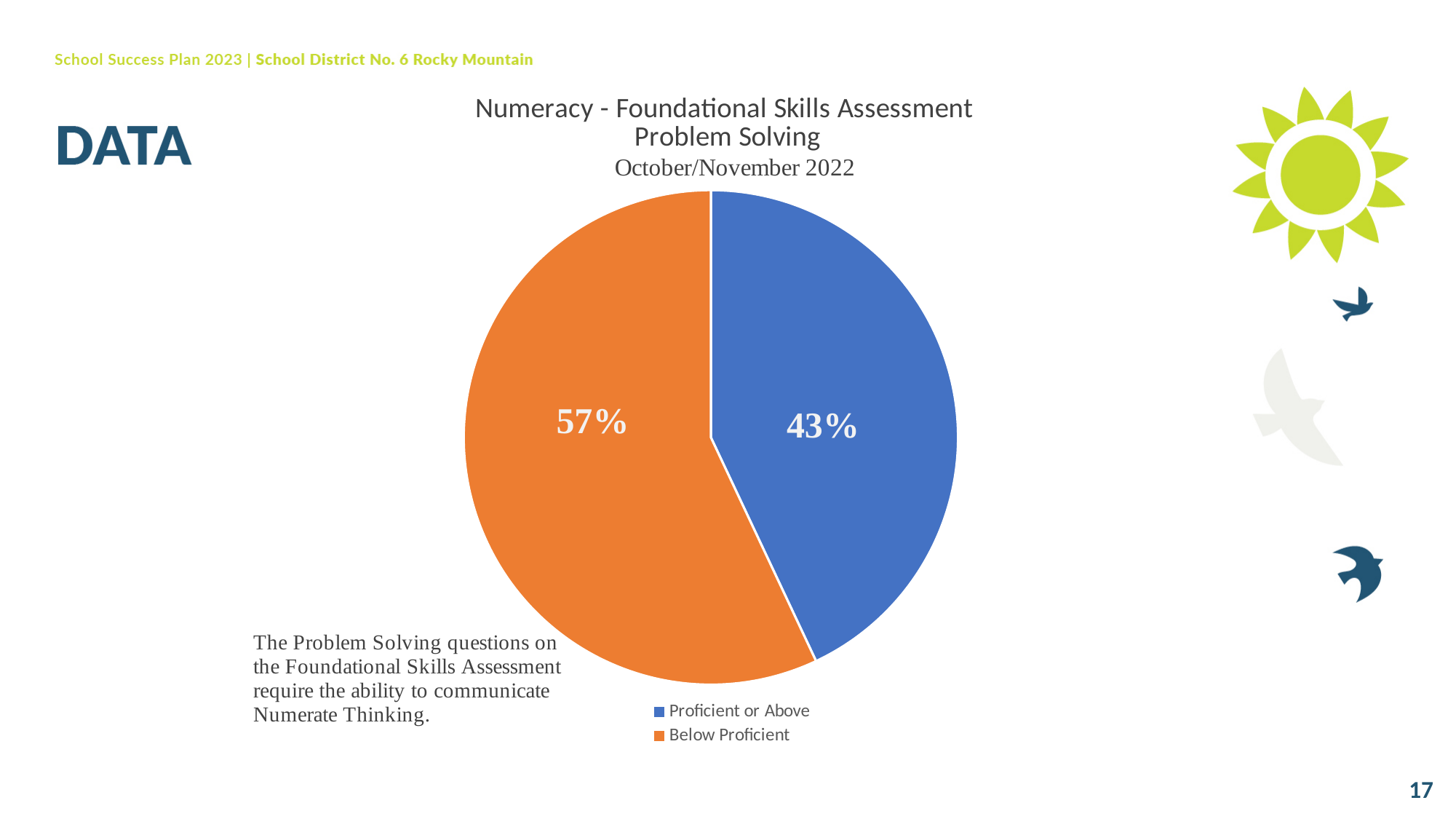
How many entries does the legend list? 2 Which colour represents Proficient or Above in the pie chart? blue What is the share of the pie for Below Proficient? 57% What percentage of the pie is labelled Proficient or Above? 43% Which category has the smaller share of the pie? Proficient or Above How many categories does the pie chart show? 2 What percentage of the pie is labelled Below Proficient? 57% What kind of chart is shown on the slide? pie chart Is the share for Proficient or Above larger or smaller than the share for Below Proficient? smaller What is the title of the chart? Numeracy - Foundational Skills Assessment Problem Solving What is the difference in percentage points between Below Proficient and Proficient or Above? 14 Which category has the larger share of the pie? Below Proficient